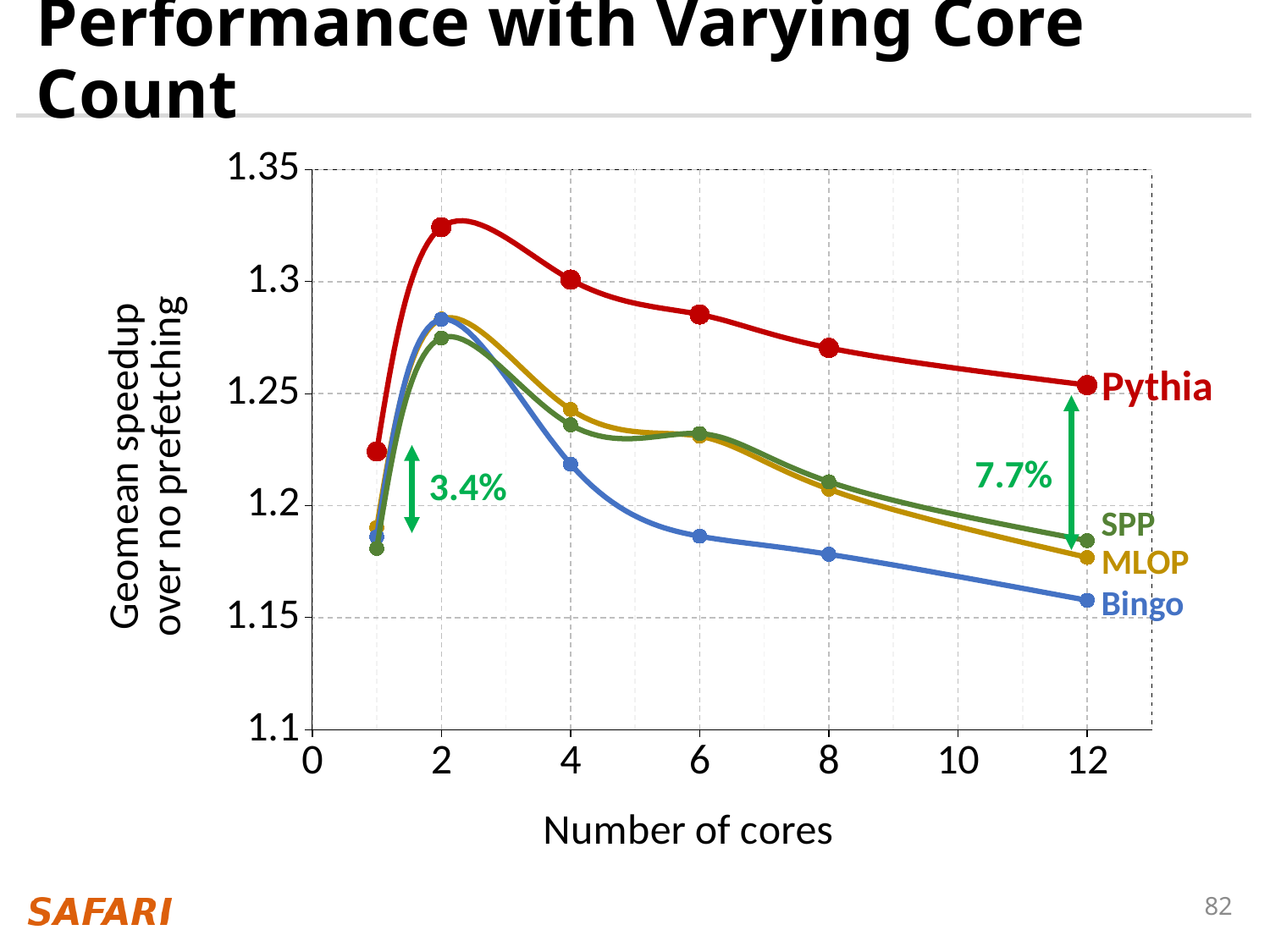
Which series has the highest geomean speedup at 12 cores? Pythia From 2 cores to 12 cores, does the Pythia line rise or fall? fall At which number of cores does Pythia reach its highest geomean speedup? 2 Is the value for Pythia at 8 cores greater or less than 1.25? greater How many series are labelled on the chart? 4 At 4 cores, which is higher, MLOP or Bingo? MLOP What kind of chart is shown on the slide? line chart Is the value for Pythia at 2 cores greater or less than 1.3? greater What is the title of the x axis? Number of cores Which series has the lowest geomean speedup at 12 cores? Bingo What percentage improvement is annotated between Pythia and the next-best prefetcher at 12 cores? 7.7% Is the value for Bingo at 12 cores greater or less than 1.2? less